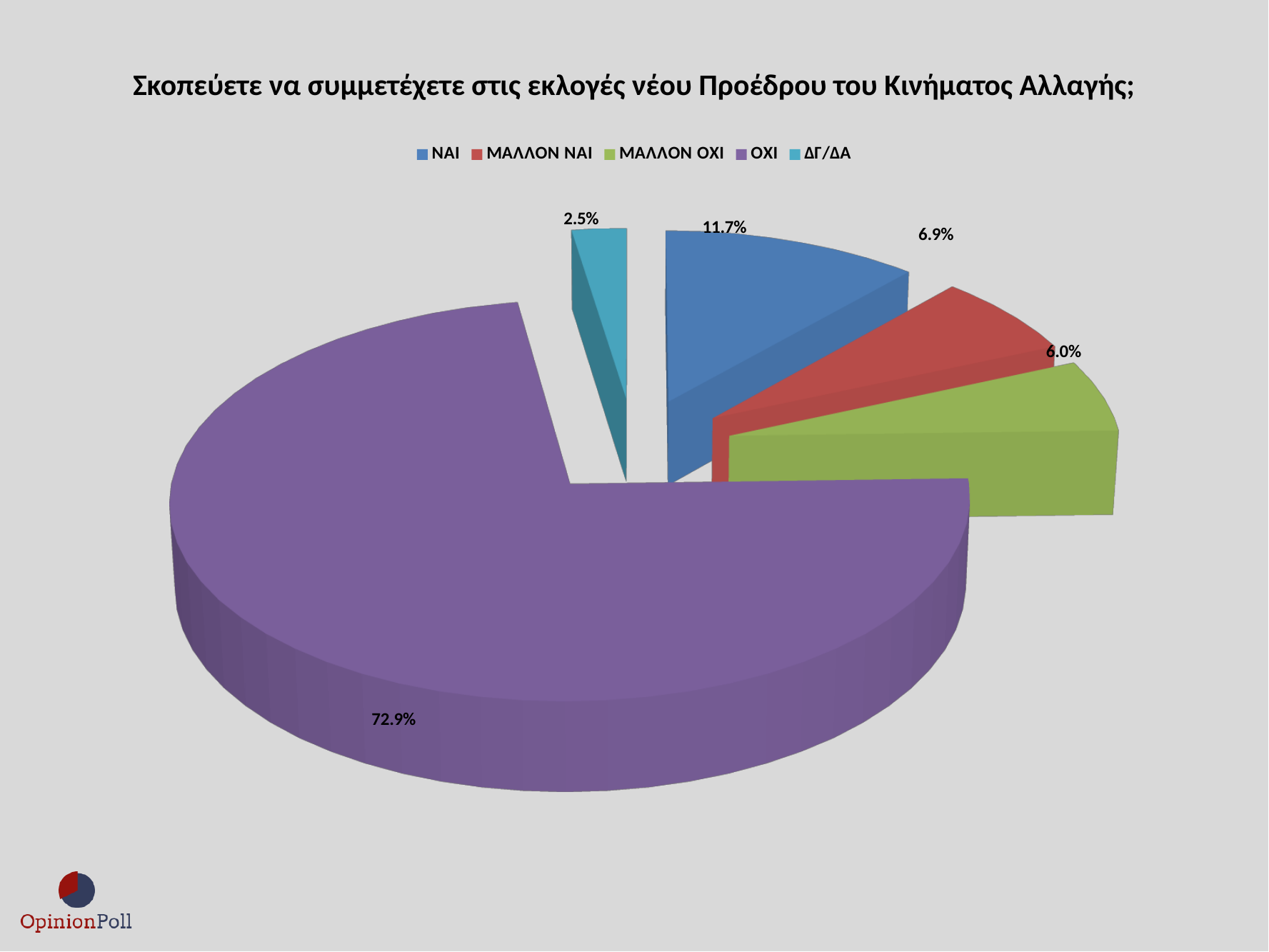
What is the value for ΜΑΛΛΟΝ ΟΧΙ? 6.0% Which category has the largest share of the pie? ΟΧΙ What is the value for ΟΧΙ? 72.9% What is the difference between the values for ΟΧΙ and ΝΑΙ? 61.2% How many categories does the legend list? 5 What colour is the ΟΧΙ slice? purple Which category has the smallest share of the pie? ΔΓ/ΔΑ What kind of chart is shown on the slide? pie chart Which is larger, the value for ΜΑΛΛΟΝ ΝΑΙ or the value for ΜΑΛΛΟΝ ΟΧΙ? ΜΑΛΛΟΝ ΝΑΙ What is the value for ΝΑΙ? 11.7% What is the value for ΜΑΛΛΟΝ ΝΑΙ? 6.9% What is the value for ΔΓ/ΔΑ? 2.5%